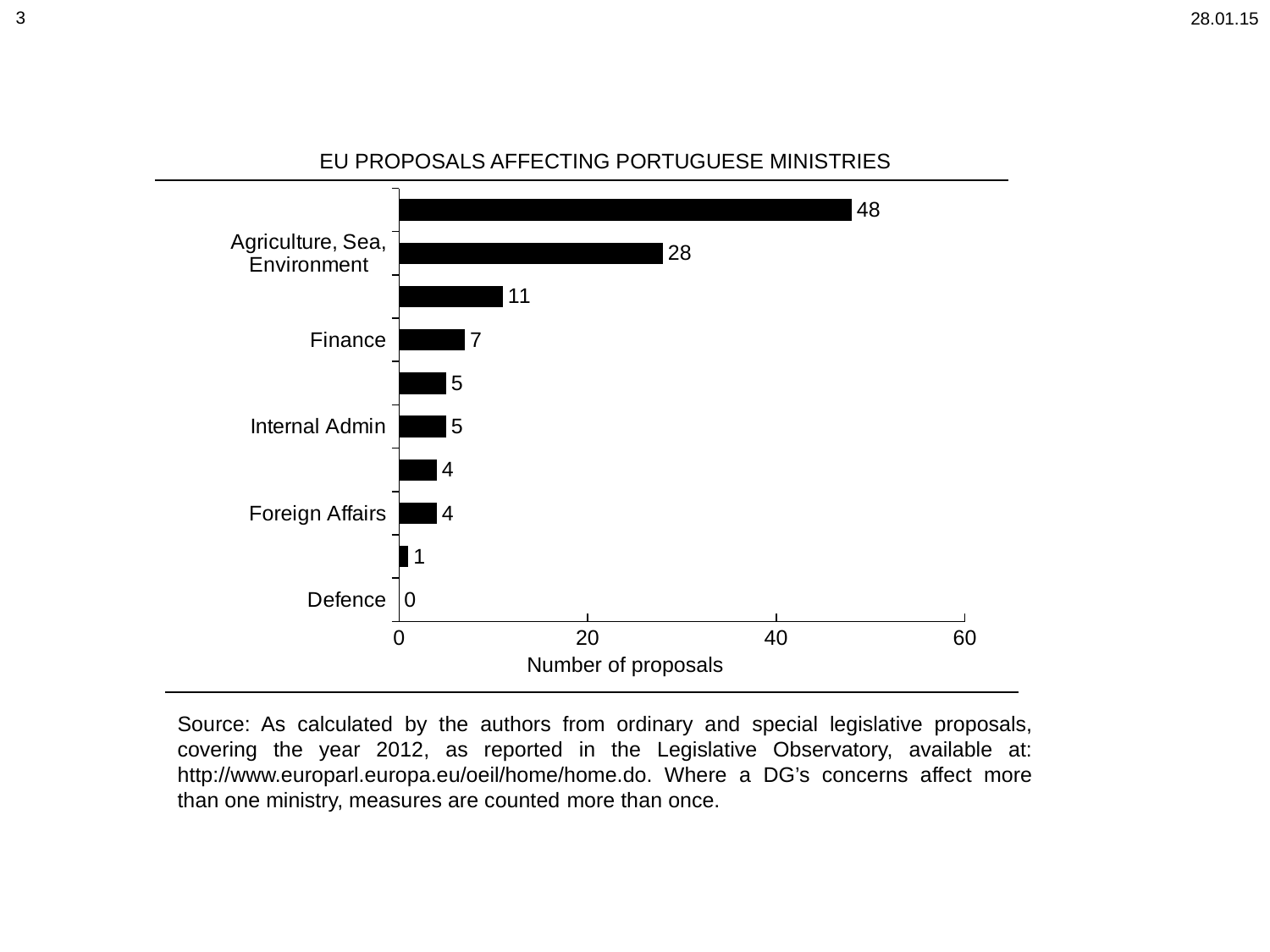
What is the number of proposals for Agriculture, Sea, Environment? 28 What is the title of the horizontal axis? Number of proposals Which has more proposals, Finance or Internal Admin? Finance What is the number of proposals for Finance? 7 What is the difference in number of proposals between Agriculture, Sea, Environment and Finance? 21 What is the largest value shown on any bar in the chart? 48 Which labelled ministry has the lowest number of proposals? Defence What kind of chart is shown on the slide? Bar chart What is the number of proposals for Defence? 0 What is the number of proposals for Internal Admin? 5 What is the number of proposals for Foreign Affairs? 4 How many bars are plotted in the chart? 10